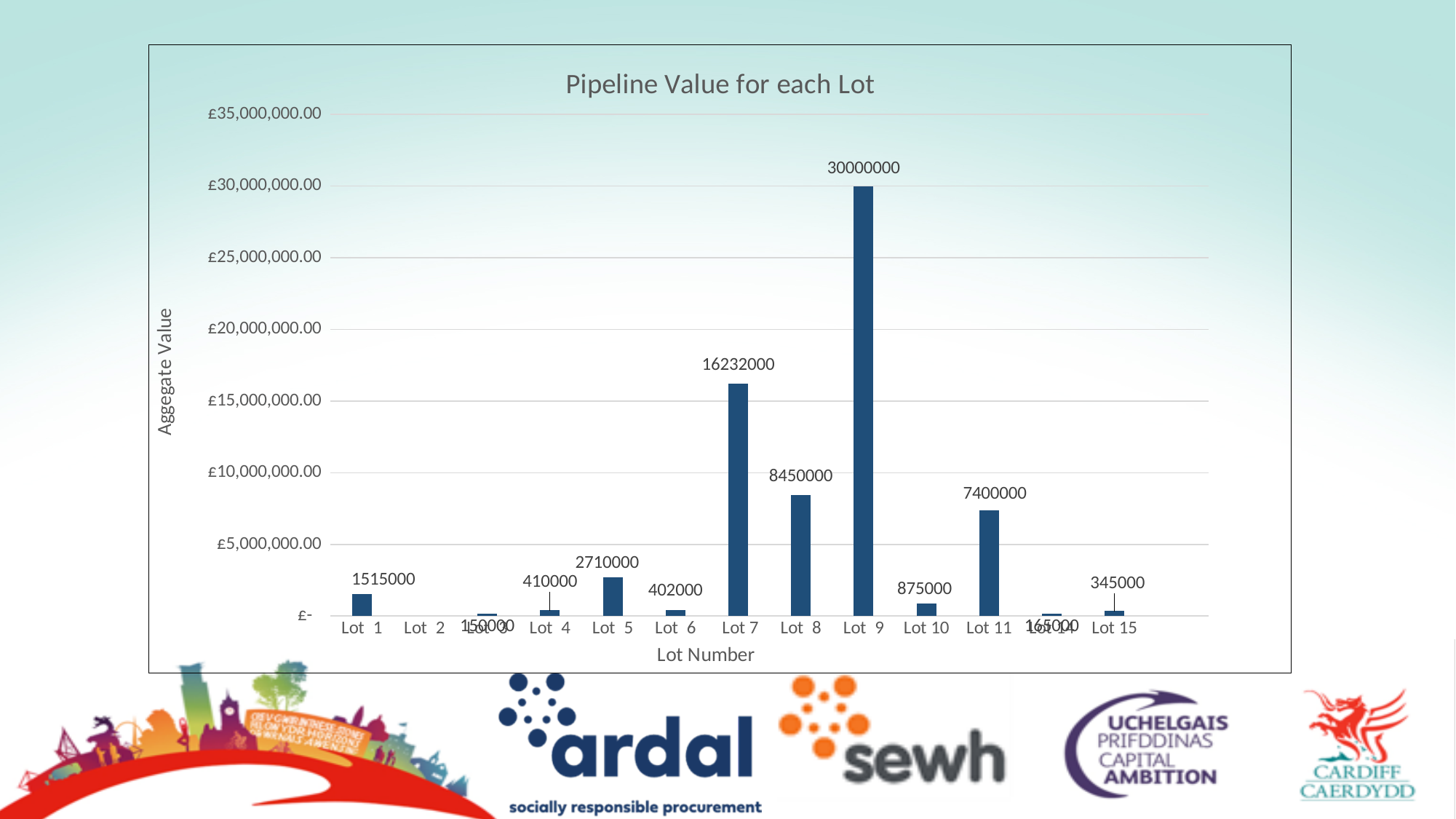
What is the pipeline value for Lot 11? 7400000 Which has a larger pipeline value, Lot 5 or Lot 10? Lot 5 Which lot has the highest pipeline value? Lot 9 Is the value for Lot 7 greater or less than £15,000,000.00? greater What kind of chart is shown on the slide? bar chart What is the pipeline value for Lot 7? 16232000 What is the difference between the pipeline values of Lot 9 and Lot 7? 13768000 What is the pipeline value for Lot 1? 1515000 What is the pipeline value for Lot 8? 8450000 What is the difference between the pipeline values of Lot 8 and Lot 11? 1050000 What is the pipeline value for Lot 9? 30000000 What is the title of the chart? Pipeline Value for each Lot